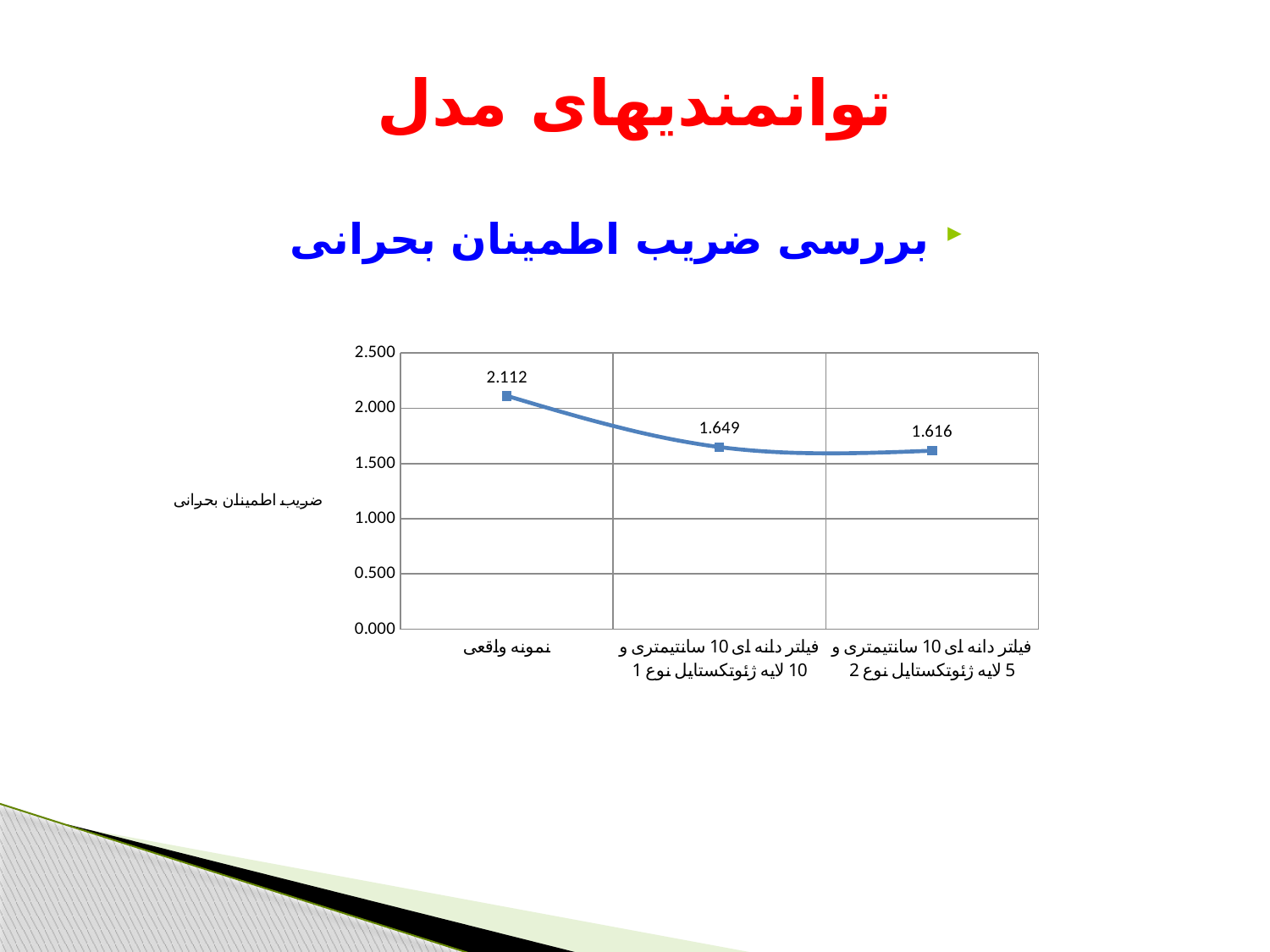
Which category has the highest value? نمونه واقعی What is the difference between the value for نمونه واقعی and the value for فیلتر دانه ای 10 سانتیمتری و 10 لایه ژئوتکستایل نوع 1? 0.463 What kind of chart is shown on the slide? line chart Which category has the lowest value? فیلتر دانه ای 10 سانتیمتری و 5 لایه ژئوتکستایل نوع 2 What is the value for نمونه واقعی? 2.112 What is the value for فیلتر دانه ای 10 سانتیمتری و 5 لایه ژئوتکستایل نوع 2? 1.616 How many categories are plotted on the x axis? 3 What is the label of the vertical axis? ضریب اطمینان بحرانی Is the value for نمونه واقعی greater or less than 2.000? greater Which is larger: the value for نمونه واقعی or the value for فیلتر دانه ای 10 سانتیمتری و 5 لایه ژئوتکستایل نوع 2? نمونه واقعی What is the value for فیلتر دانه ای 10 سانتیمتری و 10 لایه ژئوتکستایل نوع 1? 1.649 What is the difference between the value for فیلتر دانه ای 10 سانتیمتری و 10 لایه ژئوتکستایل نوع 1 and the value for فیلتر دانه ای 10 سانتیمتری و 5 لایه ژئوتکستایل نوع 2? 0.033